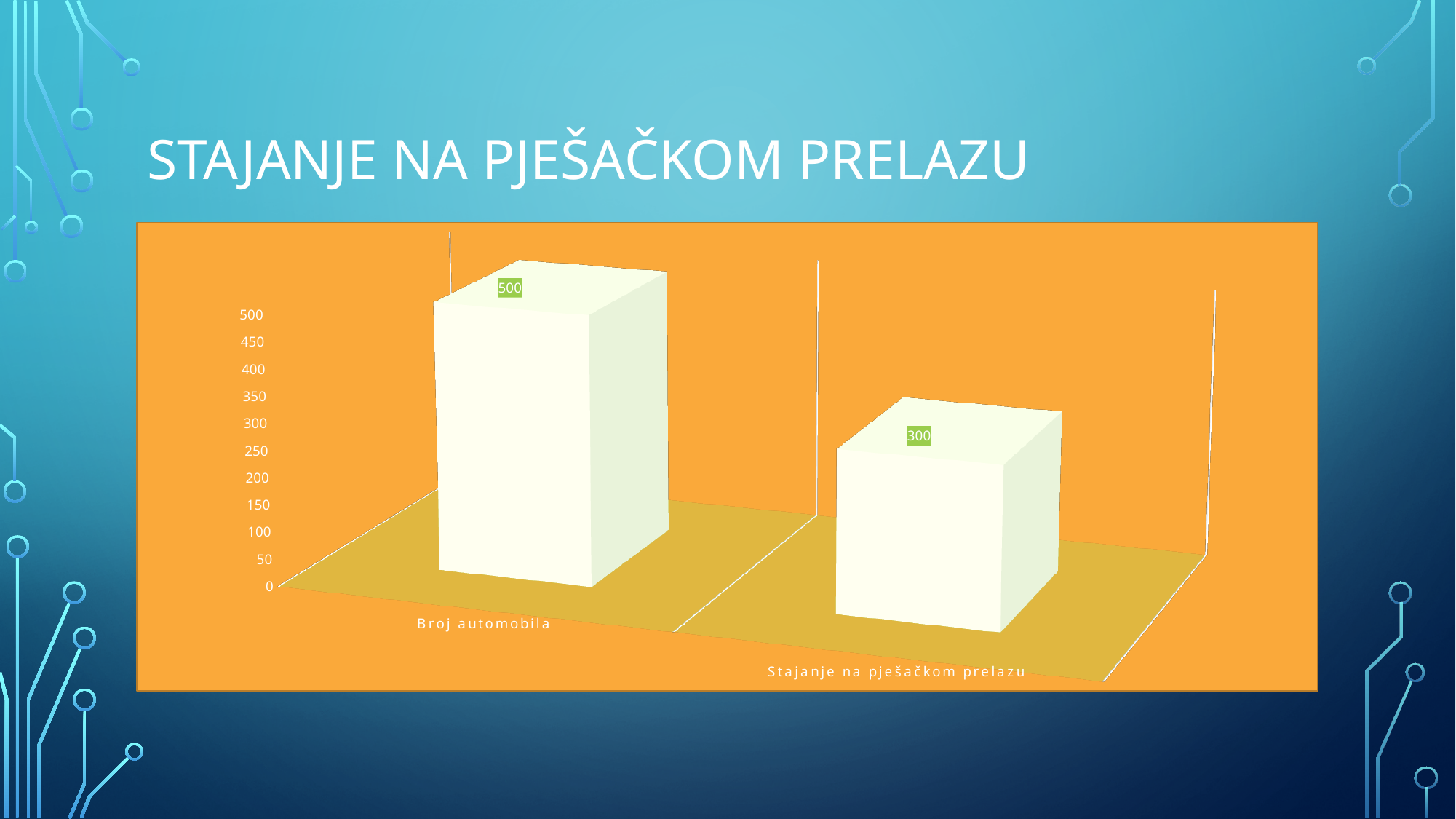
Which category has the lowest value? Stajanje na pješačkom prelazu What is the value for Broj automobila? 500 Is the value for Stajanje na pješačkom prelazu greater or less than 400? less What kind of chart is shown on the slide? bar chart Which category has the highest value? Broj automobila What is the title of the slide? Stajanje na pješačkom prelazu Do the values rise or fall from left to right along the x axis? fall What is the value for Stajanje na pješačkom prelazu? 300 Is the value for Broj automobila greater or less than 450? greater How many categories are shown in the chart? 2 Which is larger, the value for Broj automobila or the value for Stajanje na pješačkom prelazu? Broj automobila What is the difference between the values for Broj automobila and Stajanje na pješačkom prelazu? 200